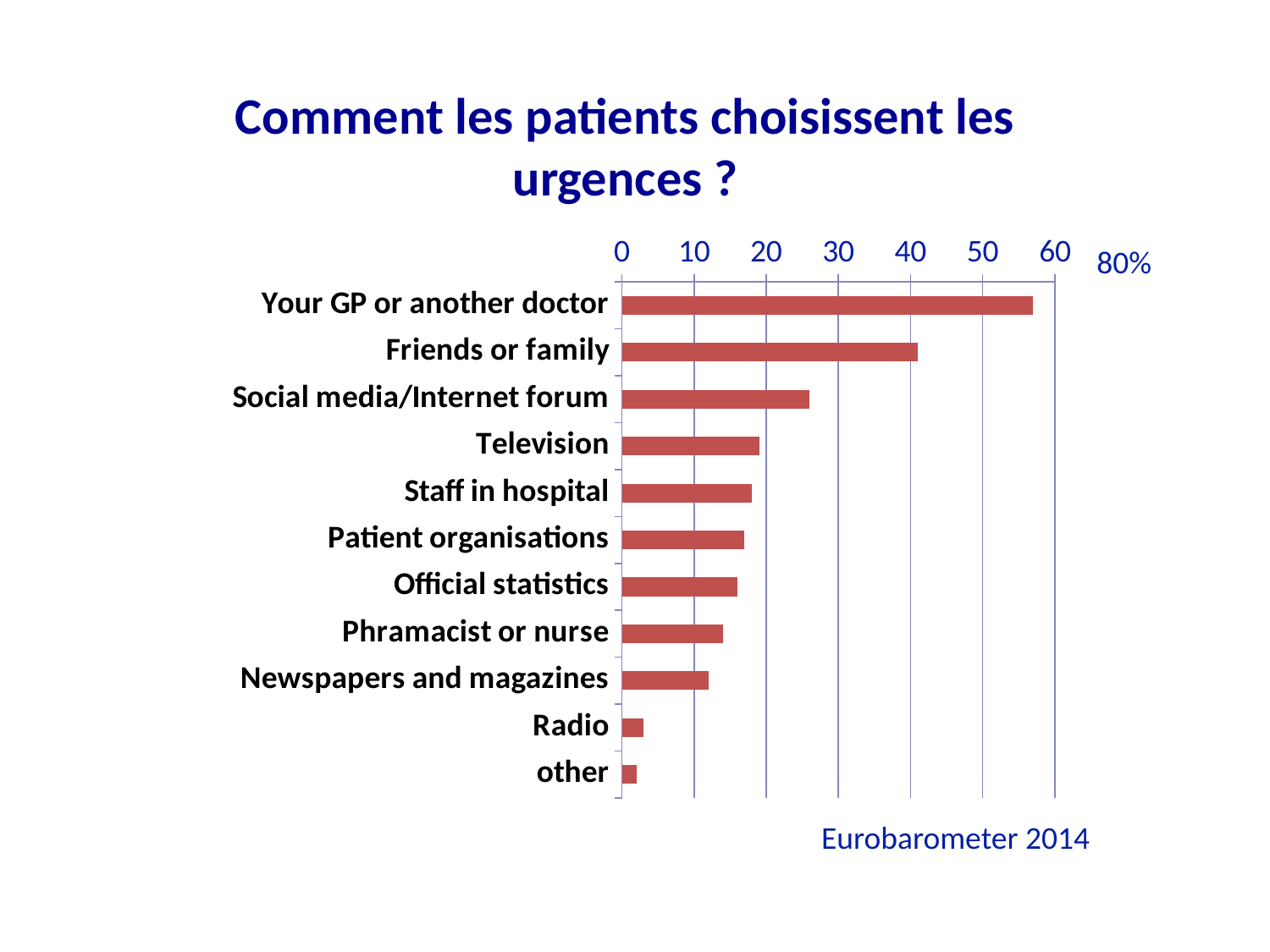
Which category has the highest value? Your GP or another doctor Which is larger, the value for Friends or family or the value for Social media/Internet forum? Friends or family What is the title of the slide containing the chart? Comment les patients choisissent les urgences ? Is the value for Your GP or another doctor greater or less than 50? greater What source is cited below the chart? Eurobarometer 2014 How many categories are plotted in the chart? 11 What kind of chart is shown on the slide? bar chart Is the value for Radio greater or less than 10? less Is the value for Social media/Internet forum greater or less than 30? less Which is larger, the value for Television or the value for Newspapers and magazines? Television Which category has the lowest value? other